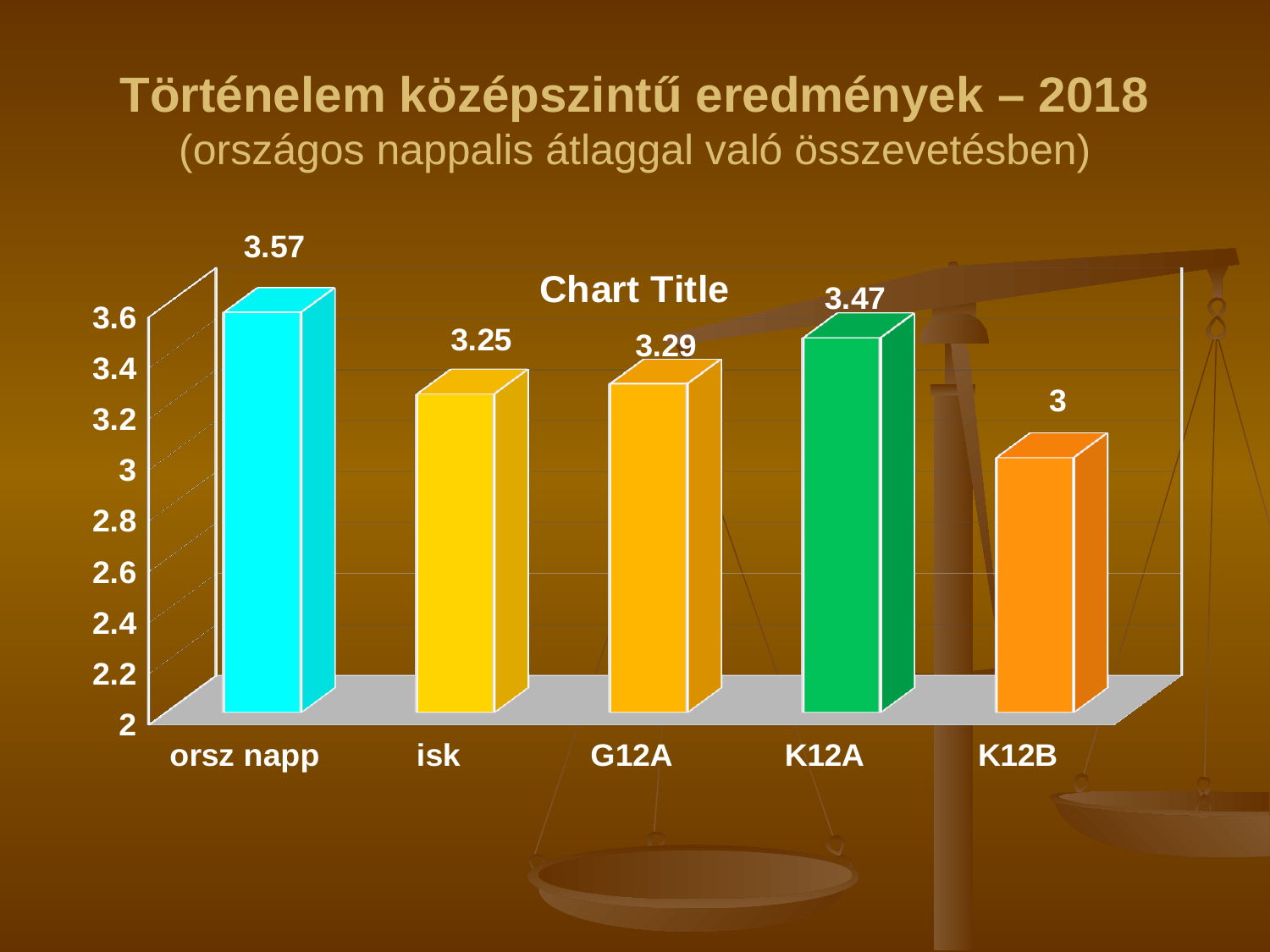
Which category has the lowest value? K12B Which is larger, the value for isk or the value for K12A? K12A What is the difference between the values for orsz napp and isk? 0.32 What kind of chart is shown on the slide? bar chart What is the difference between the values for K12A and K12B? 0.47 What is the title printed inside the chart area? Chart Title What is the value for orsz napp? 3.57 What is the value for K12B? 3 What is the value for K12A? 3.47 How many categories are shown on the x axis? 5 What is the value for G12A? 3.29 Which category has the highest value? orsz napp